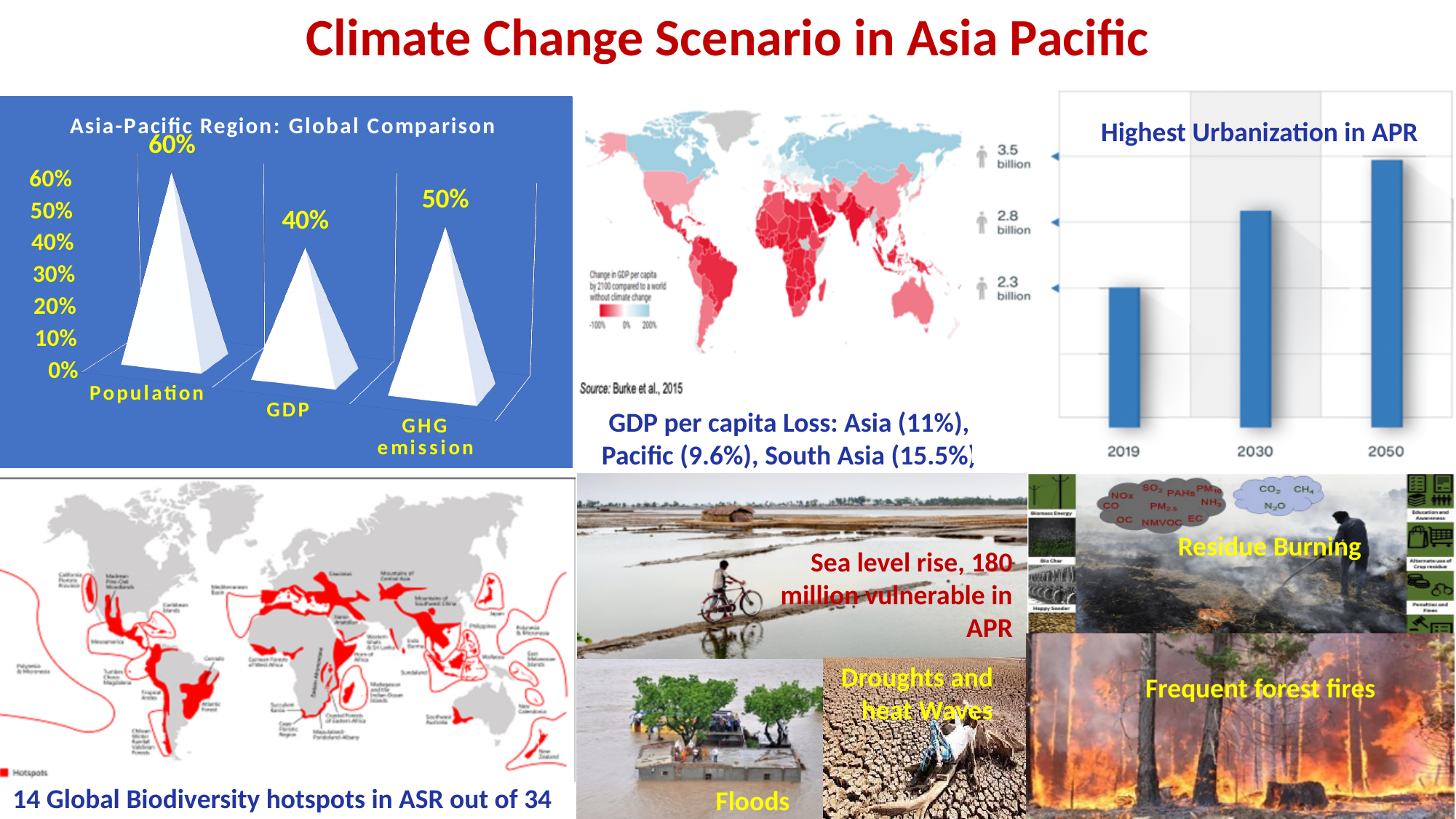
In the 'Highest Urbanization in APR' chart, do the values rise or fall from 2019 to 2050? rise In the 'Asia-Pacific Region: Global Comparison' chart, what is the value for Population? 60% In the 'Highest Urbanization in APR' chart, what value does the 2050 bar reach? 3.5 billion What kind of chart is the 'Highest Urbanization in APR' chart? bar chart In the 'Asia-Pacific Region: Global Comparison' chart, which category has the highest value? Population In the 'Asia-Pacific Region: Global Comparison' chart, what is the value for GHG emission? 50% In the 'Highest Urbanization in APR' chart, what value does the 2019 bar reach? 2.3 billion In the 'Asia-Pacific Region: Global Comparison' chart, how many categories are shown? 3 In the 'Highest Urbanization in APR' chart, which year has the tallest bar? 2050 In the 'Asia-Pacific Region: Global Comparison' chart, which category has the lowest value? GDP In the 'Asia-Pacific Region: Global Comparison' chart, what is the difference between the Population and GDP values? 20% In the 'Asia-Pacific Region: Global Comparison' chart, what is the value for GDP? 40%